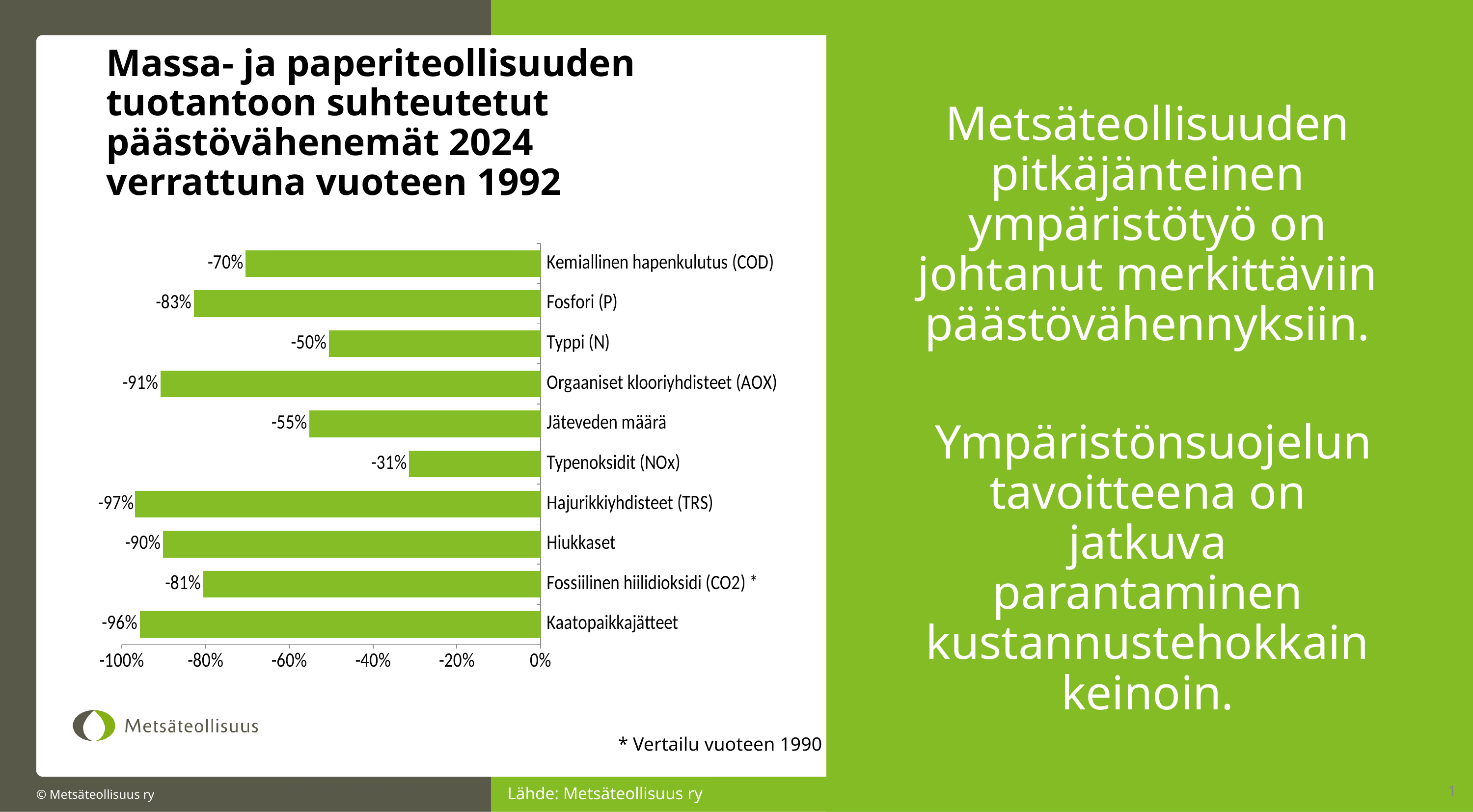
What is the value shown for Kemiallinen hapenkulutus (COD)? -70% What is the value shown for Orgaaniset klooriyhdisteet (AOX)? -91% What is the value shown for Kaatopaikkajätteet? -96% What is the value shown for Typenoksidit (NOx)? -31% According to the footnote, which year is the Fossiilinen hiilidioksidi (CO2) value compared to? 1990 Which category shows the smallest reduction (the highest value)? Typenoksidit (NOx) What is the difference in percentage points between the values for Fosfori (P) and Typpi (N)? 33 percentage points What is the value shown for Jäteveden määrä? -55% Which shows a larger reduction, Hiukkaset or Fossiilinen hiilidioksidi (CO2)? Hiukkaset Which category shows the largest reduction (the lowest value)? Hajurikkiyhdisteet (TRS) How many categories are plotted in the chart? 10 What kind of chart is shown on the slide? Bar chart